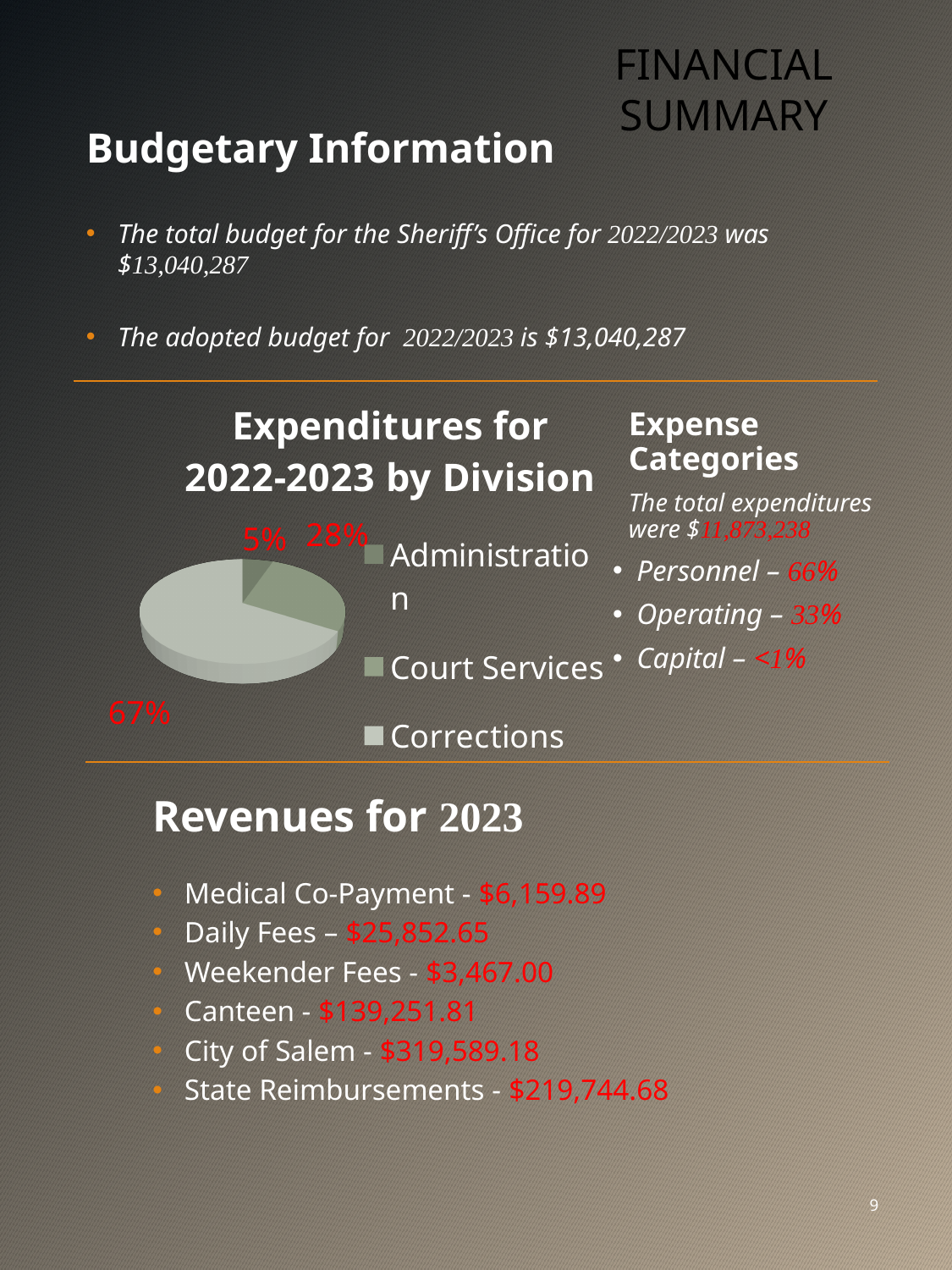
In the "Expenditures for 2022-2023 by Division" pie chart, what is the difference in percentage points between the Court Services share and the Administration share? 23 percentage points How many slices does the "Expenditures for 2022-2023 by Division" pie chart have? 3 What is the title of the pie chart on the slide? Expenditures for 2022-2023 by Division What percentage of expenditures does Court Services account for in the "Expenditures for 2022-2023 by Division" pie chart? 28% What percentage of expenditures does Corrections account for in the "Expenditures for 2022-2023 by Division" pie chart? 67% In the "Expenditures for 2022-2023 by Division" pie chart, what is the difference in percentage points between the Corrections share and the Court Services share? 39 percentage points What percentage of expenditures does Administration account for in the "Expenditures for 2022-2023 by Division" pie chart? 5% What are the three legend entries of the "Expenditures for 2022-2023 by Division" pie chart? Administration, Court Services, Corrections Which division has the largest share in the "Expenditures for 2022-2023 by Division" pie chart? Corrections In the "Expenditures for 2022-2023 by Division" pie chart, which is larger: the Court Services share or the Administration share? Court Services What kind of chart is shown under the title "Expenditures for 2022-2023 by Division"? Pie chart Which division has the smallest share in the "Expenditures for 2022-2023 by Division" pie chart? Administration